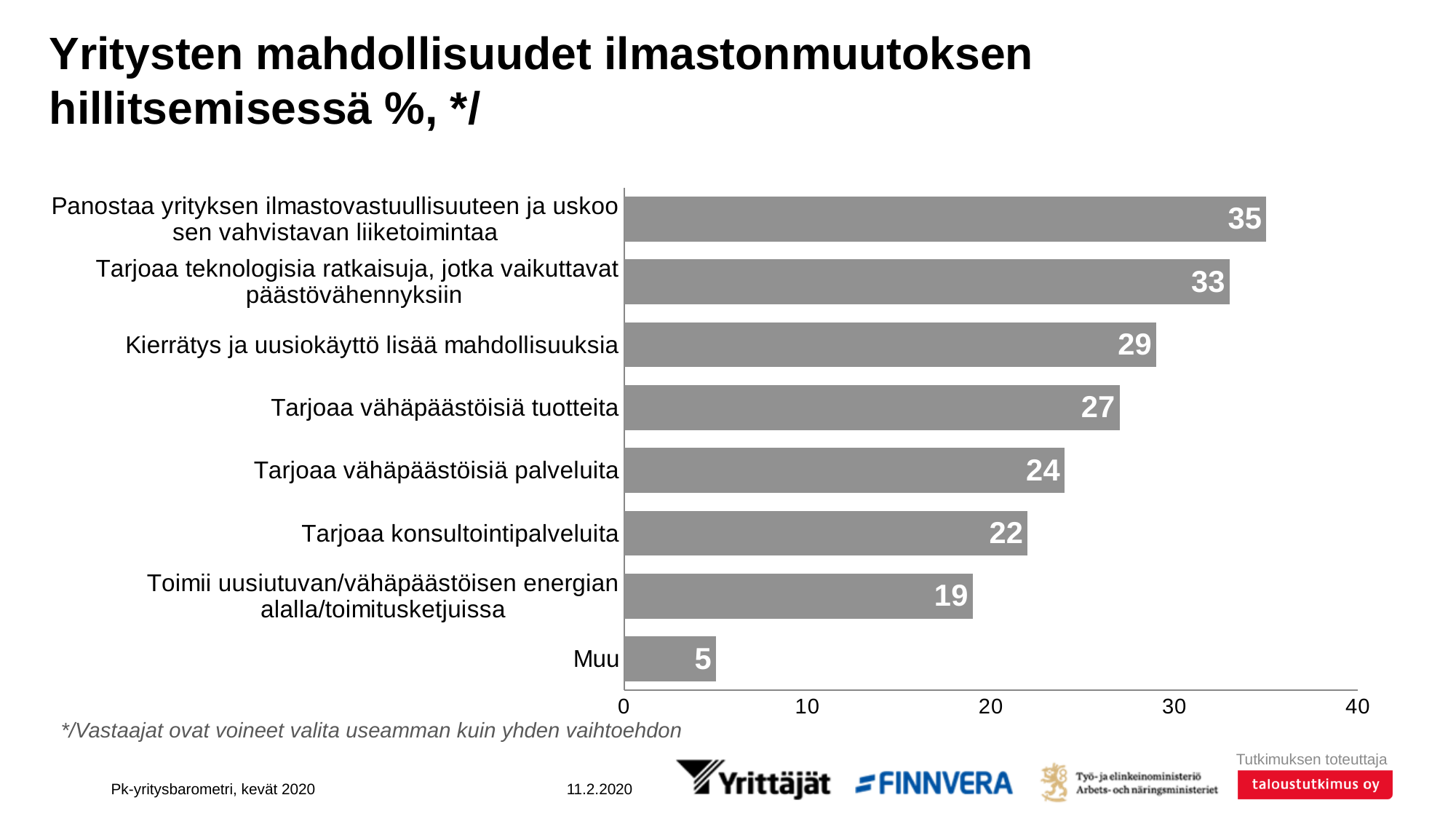
What is the value for "Kierrätys ja uusiokäyttö lisää mahdollisuuksia"? 29 What is the maximum value shown on the horizontal axis? 40 Which category has the highest value? Panostaa yrityksen ilmastovastuullisuuteen ja uskoo sen vahvistavan liiketoimintaa What is the difference between the highest and lowest values in the chart? 30 How many categories are shown in the chart? 8 What is the value for "Muu"? 5 What is the difference between the values for "Tarjoaa vähäpäästöisiä palveluita" and "Tarjoaa konsultointipalveluita"? 2 Which category has the lowest value? Muu What is the value for "Tarjoaa vähäpäästöisiä tuotteita"? 27 Is the value for "Tarjoaa konsultointipalveluita" greater or less than 20? greater Which is larger: the value for "Tarjoaa teknologisia ratkaisuja, jotka vaikuttavat päästövähennyksiin" or the value for "Toimii uusiutuvan/vähäpäästöisen energian alalla/toimitusketjuissa"? Tarjoaa teknologisia ratkaisuja, jotka vaikuttavat päästövähennyksiin What kind of chart is shown on the slide? Bar chart